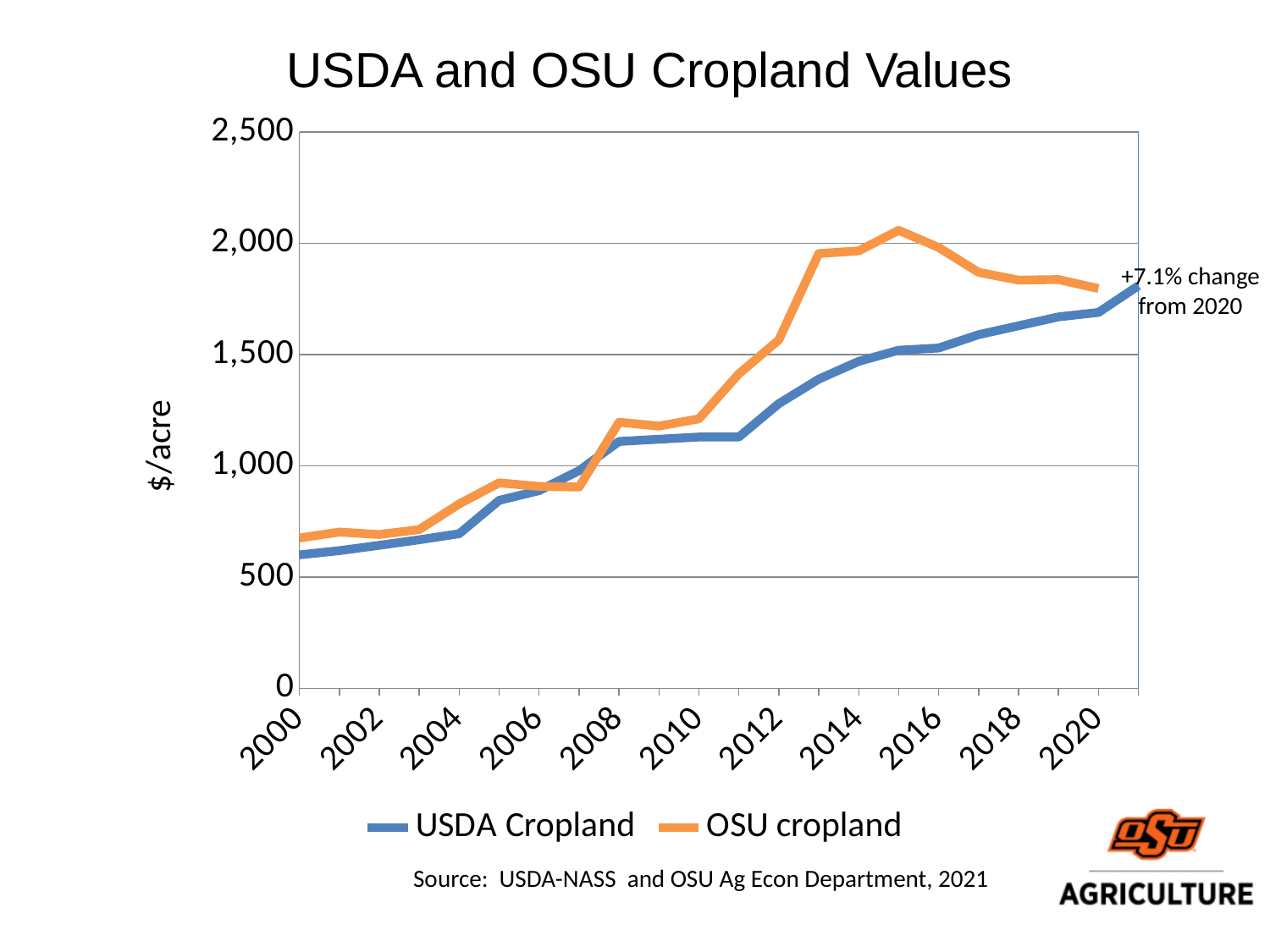
Is the USDA Cropland value in 2020 greater or less than 1,500? greater In which year is the USDA Cropland value lowest? 2000 What is the label on the vertical axis? $/acre What is the title of the chart? USDA and OSU Cropland Values What kind of chart is shown on the slide? line chart Is the OSU cropland value in 2014 greater or less than 1,500? greater How many series does the legend list? 2 Is the OSU cropland value in 2004 greater or less than 1,000? less In 2012, which series has the higher value, USDA Cropland or OSU cropland? OSU cropland In which year does the OSU cropland series reach its highest value? 2015 Does the USDA Cropland series generally rise or fall from 2000 to 2020? rise